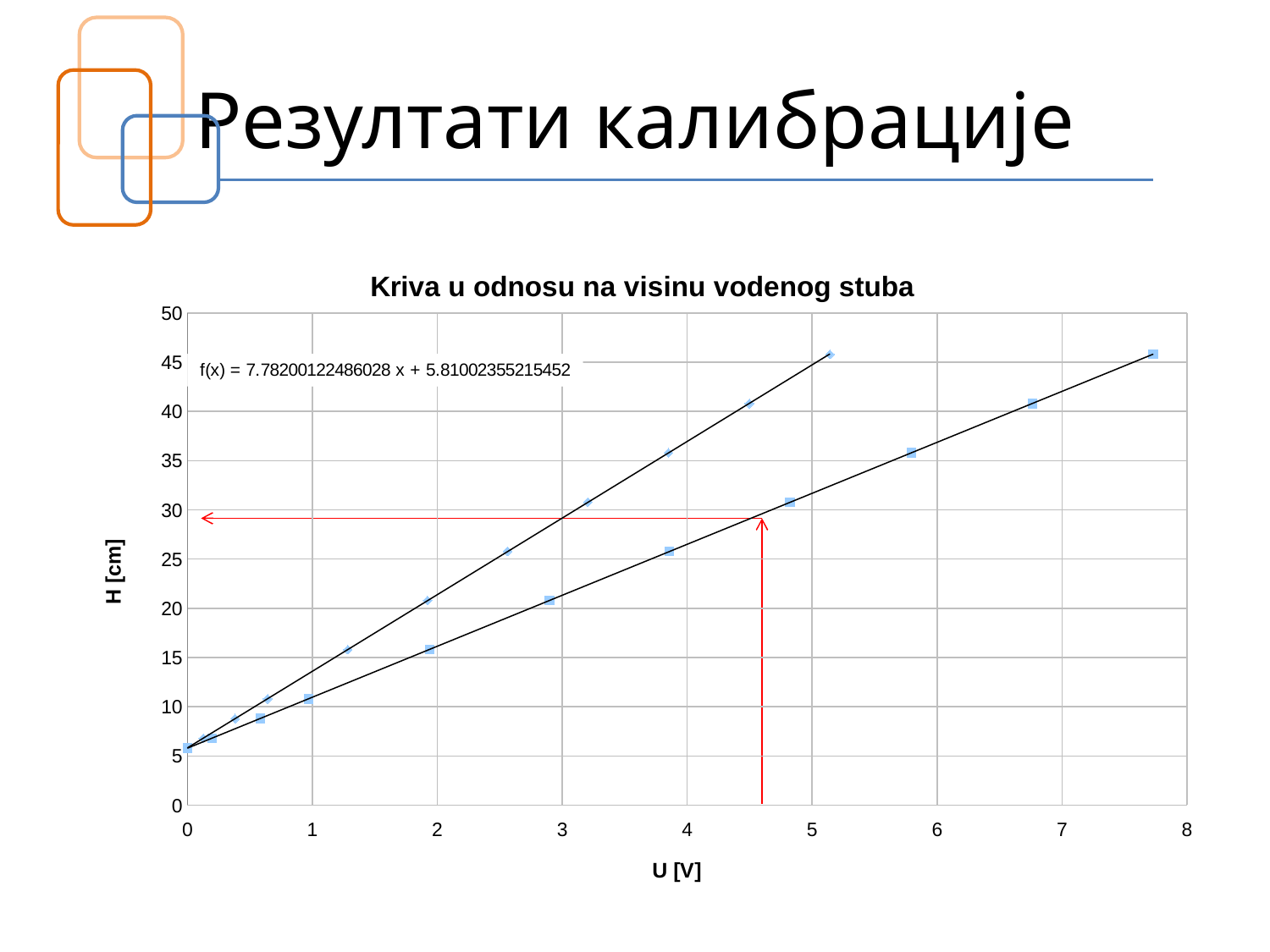
What is the equation of the trendline printed on the chart? f(x) = 7.78200122486028 x + 5.81002355215452 Is the H value of the point near U = 5.8 V on the lower line greater or less than 30? greater What is the slope in the trendline equation printed on the chart? 7.78200122486028 What kind of chart is shown on the slide? scatter chart What is the intercept in the trendline equation printed on the chart? 5.81002355215452 What is the maximum value shown on the x axis (U [V])? 8 What is the title of the chart? Kriva u odnosu na visinu vodenog stuba Is the H value of the point near U = 3.2 V on the upper line greater or less than 25? greater Is the H value of the rightmost point (near U = 7.7 V) greater or less than 40? greater What is the label of the vertical axis of the chart? H [cm] Do the values of H rise or fall as U increases along the x axis? rise